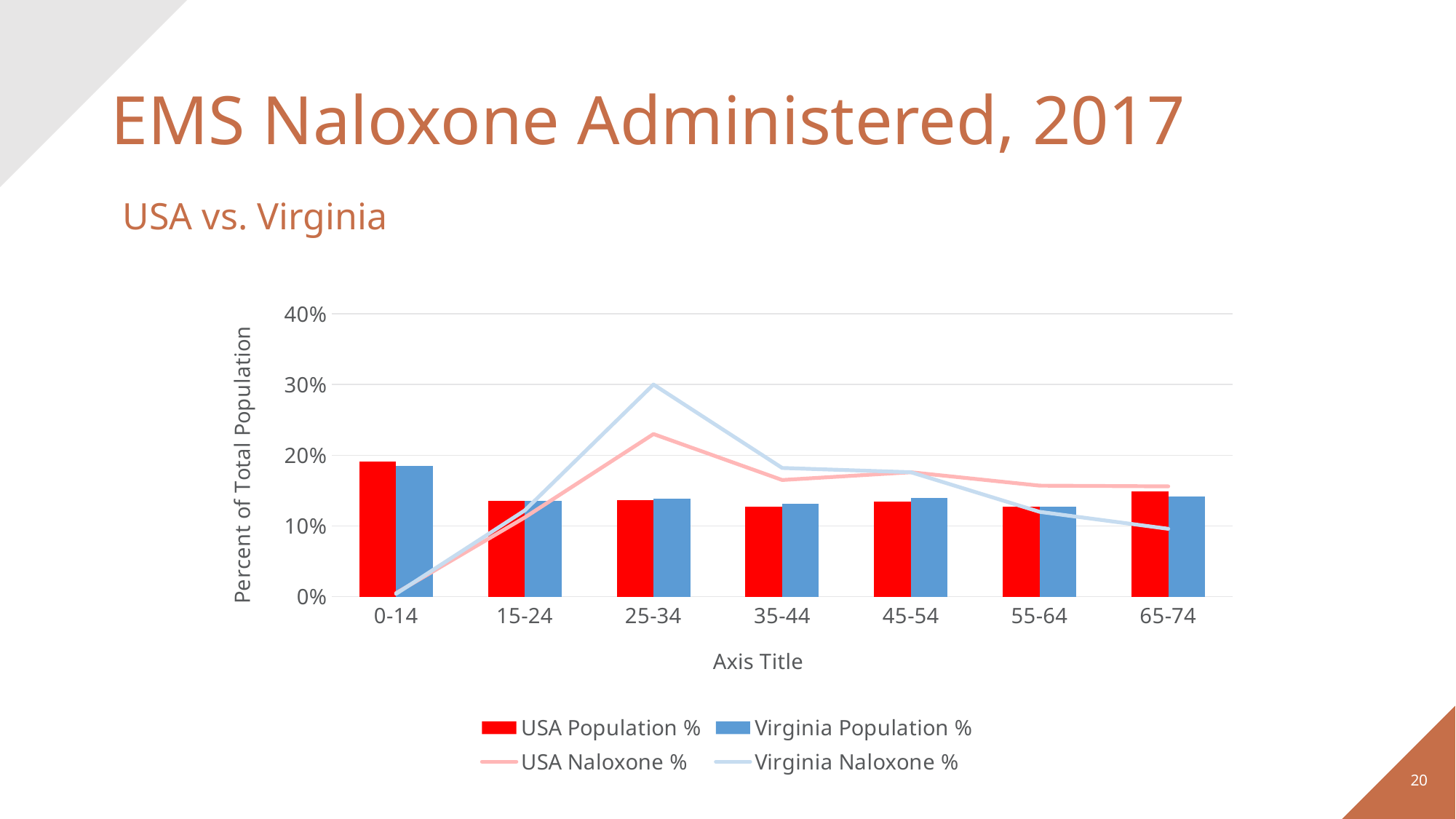
Is the Virginia Naloxone % value for 25-34 greater or less than 20%? greater What kind of chart is shown on the slide? A combined bar and line chart For which age group is Virginia Naloxone % lowest? 0-14 Is the USA Population % value for 0-14 greater or less than 15%? greater Is the USA Naloxone % value for 0-14 greater or less than 10%? less For which age group is Virginia Naloxone % highest? 25-34 How many age groups are shown on the x axis? 7 How many series does the legend list? 4 For which age group is USA Population % highest? 0-14 For the 65-74 age group, which is larger: USA Naloxone % or Virginia Naloxone %? USA Naloxone % Does Virginia Naloxone % rise or fall from the 25-34 age group to the 65-74 age group? fall For the 25-34 age group, which is larger: USA Naloxone % or Virginia Naloxone %? Virginia Naloxone %